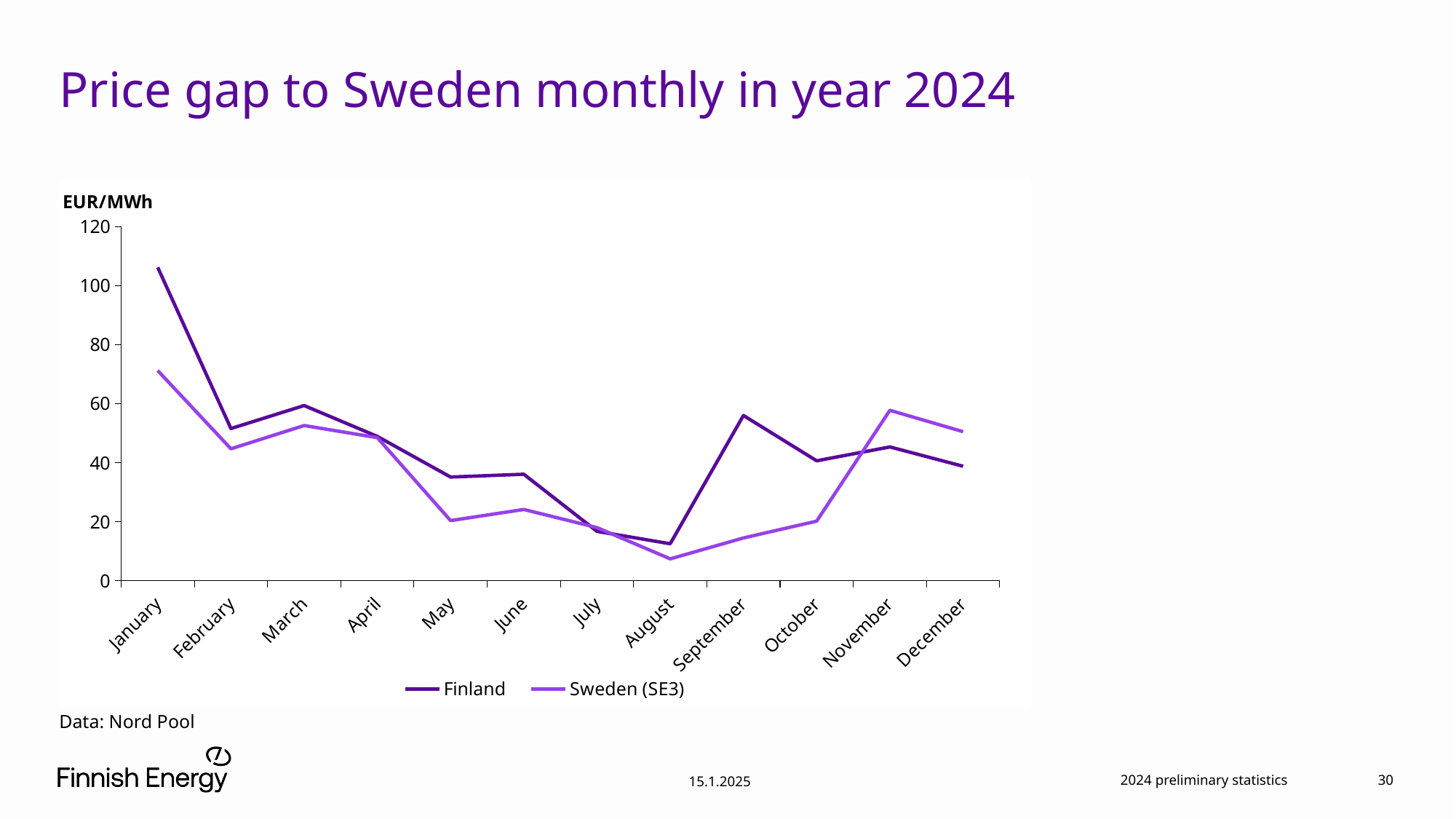
In which month is the Sweden (SE3) value highest? January In which month is the Finland value lowest? August In which month is the Finland value highest? January Is the Sweden (SE3) value for January greater or less than 80? less Is the Sweden (SE3) value for September greater or less than 20? less How many months are plotted along the x axis? 12 Which series has the higher value in November, Finland or Sweden (SE3)? Sweden (SE3) In which month is the Sweden (SE3) value lowest? August How many series does the legend list? 2 Which series has the higher value in September, Finland or Sweden (SE3)? Finland What kind of chart is shown on the slide? Line chart Is the Finland value for January greater or less than 100? greater